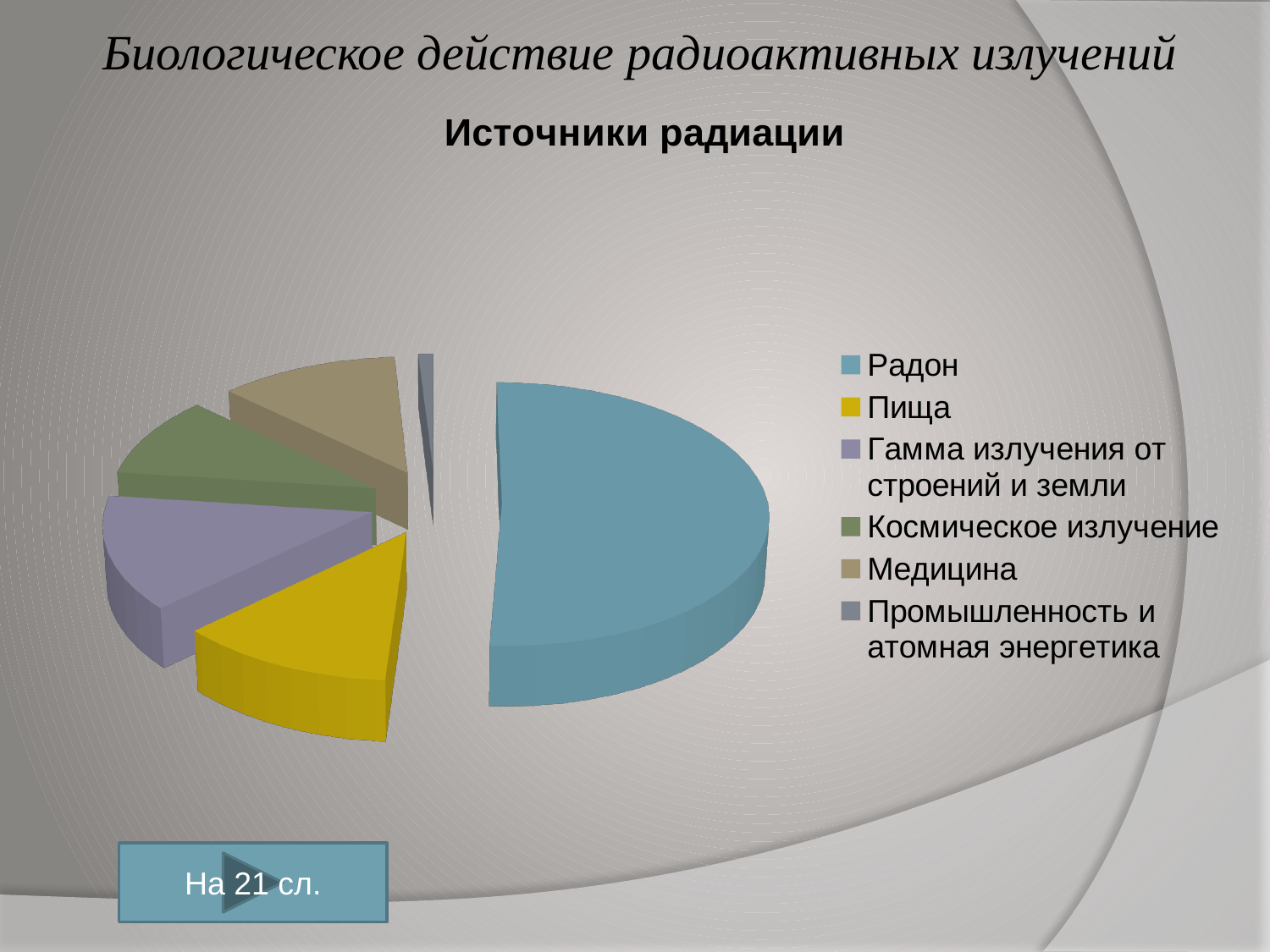
What colour is the slice for Радон? blue Which slice is larger, Радон or Пища? Радон What kind of chart is shown on the slide? pie chart Which slice is larger, Радон or Космическое излучение? Радон Which source of radiation has the largest slice of the pie? Радон Which slice is larger, Медицина or Промышленность и атомная энергетика? Медицина Which source of radiation has the smallest slice of the pie? Промышленность и атомная энергетика How many categories (slices) does the pie chart have? 6 What is the title of the chart? Источники радиации